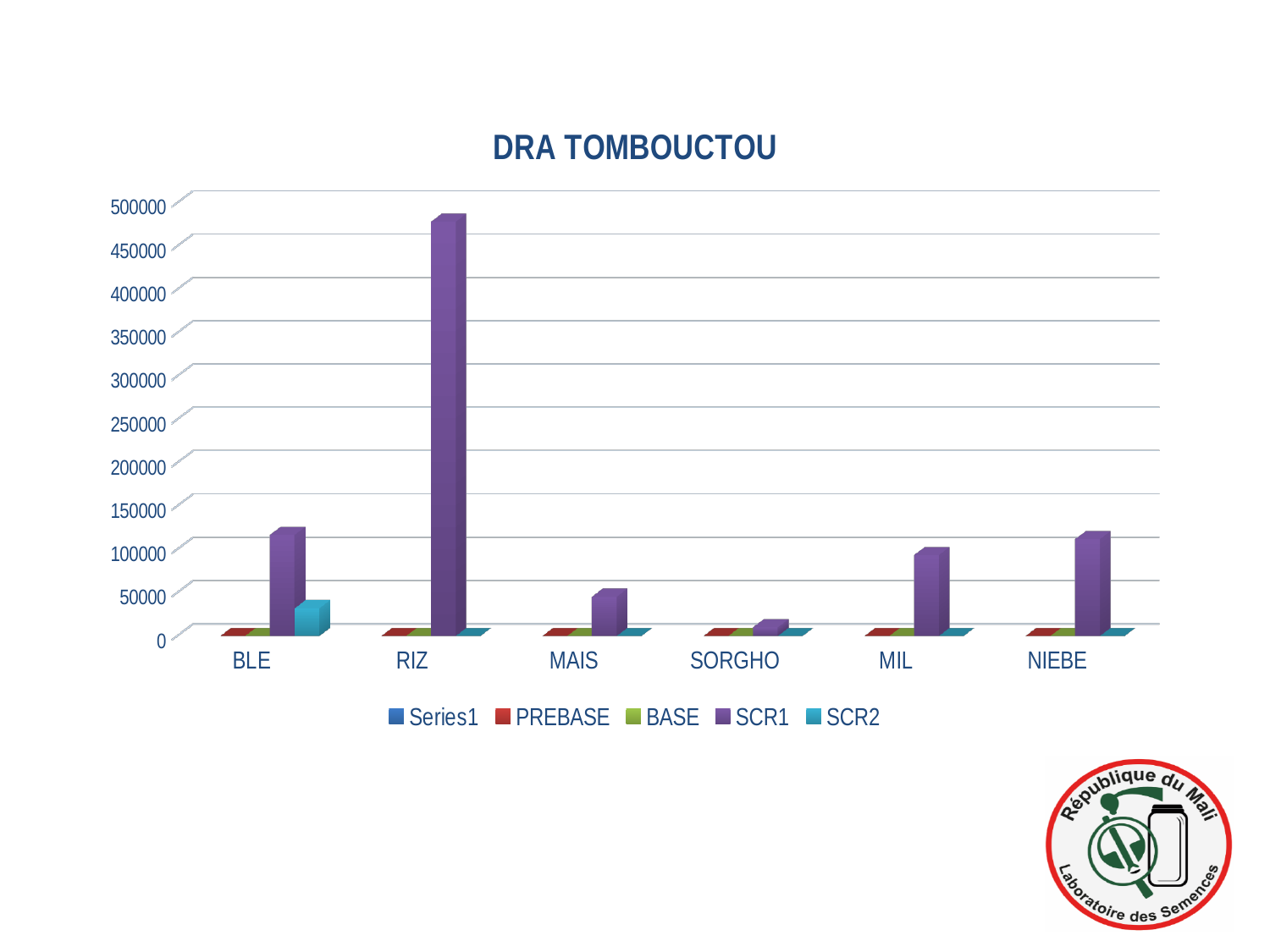
Is the SCR1 value for MAIS greater or less than 100000? less Which category has the highest SCR1 value? RIZ Which has the larger SCR1 value, RIZ or MIL? RIZ Is the SCR1 value for SORGHO greater or less than 50000? less How many series does the legend list? 5 Which category has the lowest SCR1 value? SORGHO How many categories are shown on the x axis? 6 Is the SCR1 value for MIL greater or less than 50000? greater Which has the larger SCR1 value, BLE or MAIS? BLE What kind of chart is shown on the slide? bar chart What is the title of the chart? DRA TOMBOUCTOU